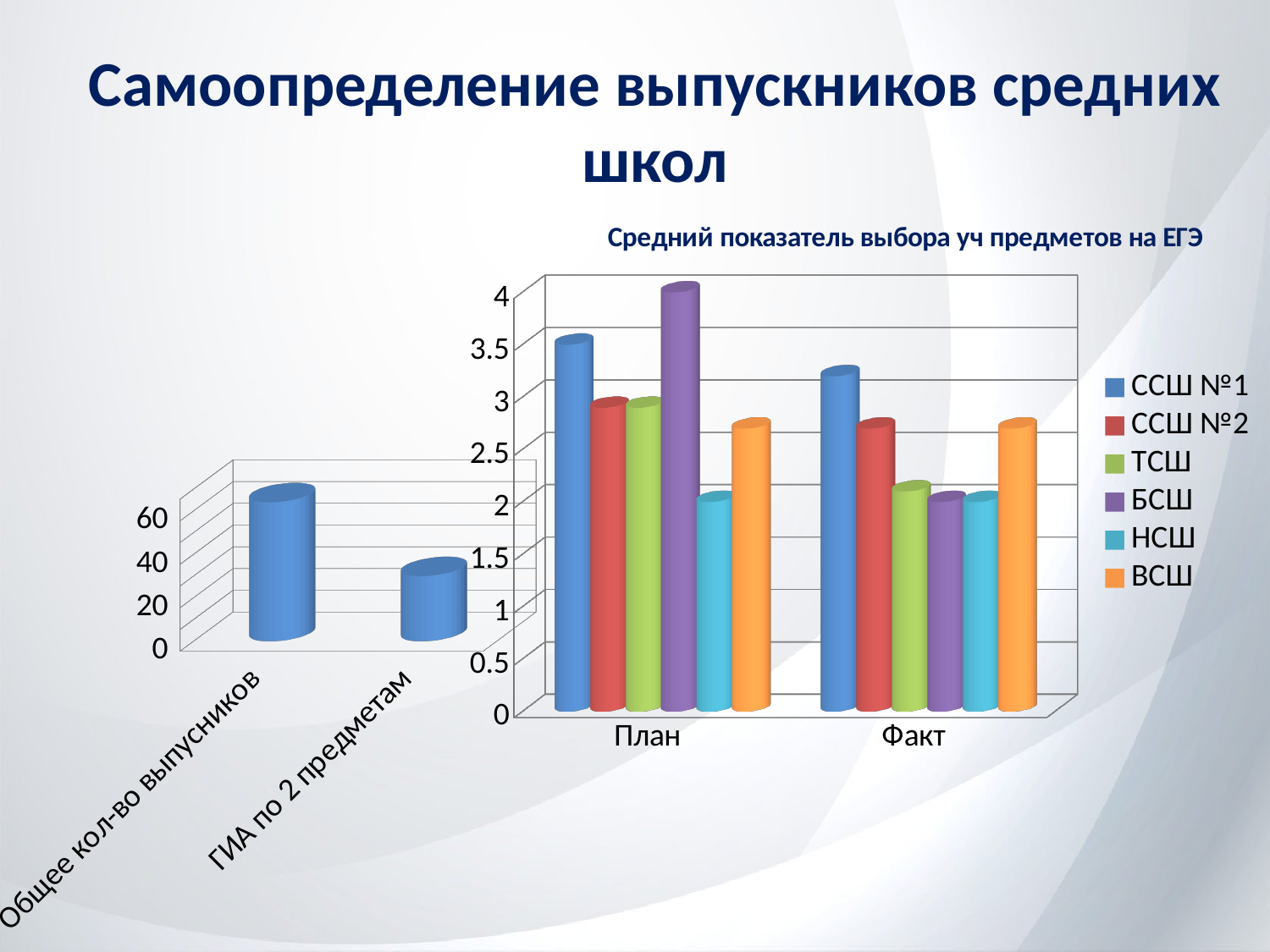
In the chart on the left of the slide, is the value for 'ГИА по 2 предметам' greater or less than 40? less In the chart 'Средний показатель выбора уч предметов на ЕГЭ', is the value for БСШ larger in План or in Факт? План In the chart 'Средний показатель выбора уч предметов на ЕГЭ', is the value for НСШ in План greater or less than 2.5? less In the chart 'Средний показатель выбора уч предметов на ЕГЭ', is the value for БСШ in План greater or less than 3.5? greater In the chart 'Средний показатель выбора уч предметов на ЕГЭ', which school has the lowest value for План? НСШ In the chart 'Средний показатель выбора уч предметов на ЕГЭ', is the value for ТСШ larger in План or in Факт? План How many categories are shown on the x axis of the chart 'Средний показатель выбора уч предметов на ЕГЭ'? 2 In the chart 'Средний показатель выбора уч предметов на ЕГЭ', which school has the highest value for Факт? ССШ №1 In the chart on the left of the slide, which category has the higher value? Общее кол-во выпускников How many series does the legend of the chart 'Средний показатель выбора уч предметов на ЕГЭ' list? 6 In the chart 'Средний показатель выбора уч предметов на ЕГЭ', which school has the highest value for План? БСШ What type of chart is the chart titled 'Средний показатель выбора уч предметов на ЕГЭ'? bar chart